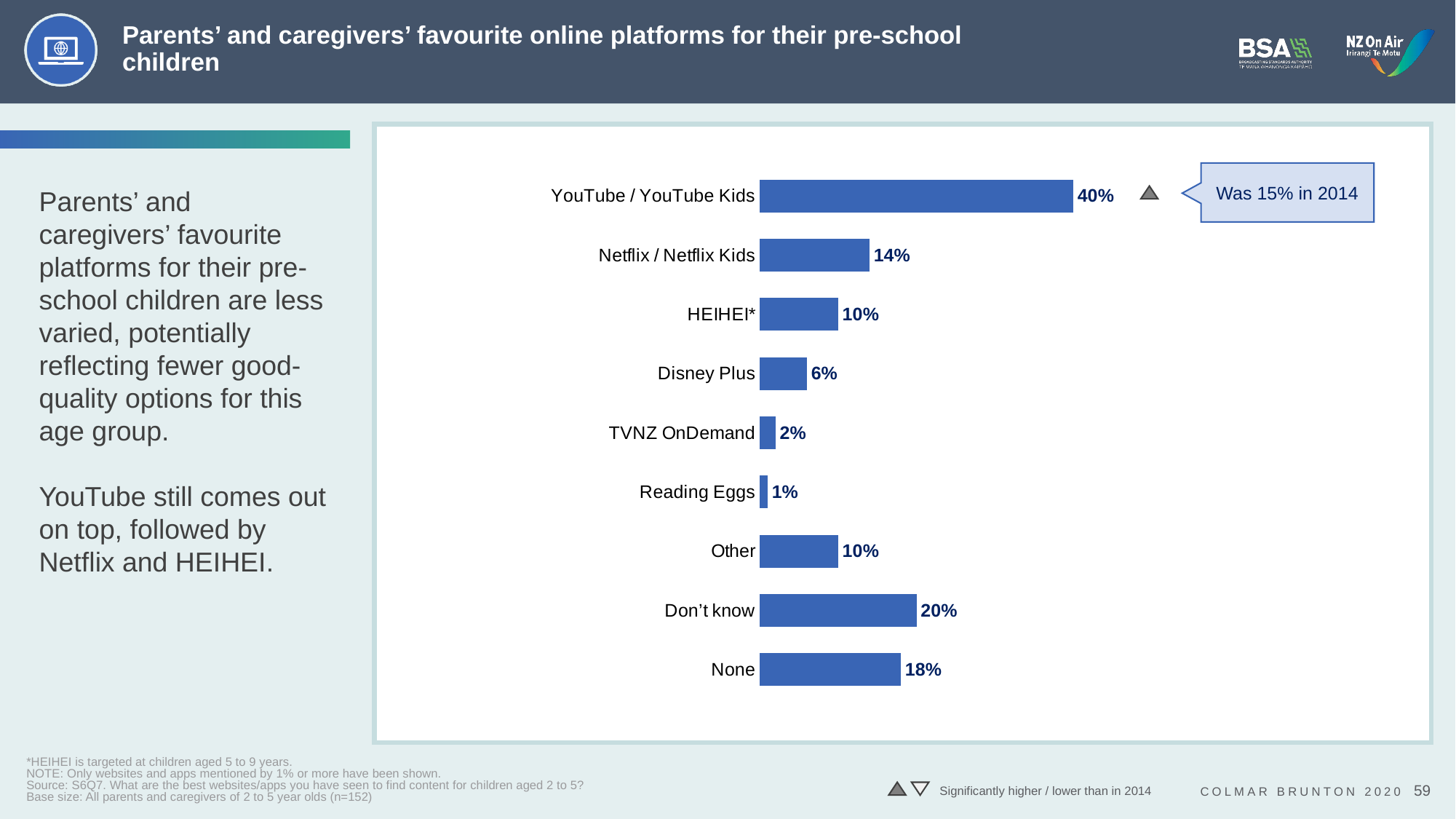
What percentage is shown for Disney Plus? 6% Which category has the highest value in the chart? YouTube / YouTube Kids What is the difference between the values for Don't know and None? 2% How many categories are shown in the chart? 9 What is the value for Don't know? 20% Which is larger, the value for HEIHEI* or the value for Disney Plus? HEIHEI* According to the callout on the chart, what was the value for YouTube / YouTube Kids in 2014? 15% What is the value shown for Netflix / Netflix Kids? 14% What percentage of parents and caregivers named YouTube / YouTube Kids as a favourite platform? 40% What kind of chart is shown on the slide? Bar chart What is the difference between the values for YouTube / YouTube Kids and Netflix / Netflix Kids? 26% Which category has the lowest value in the chart? Reading Eggs